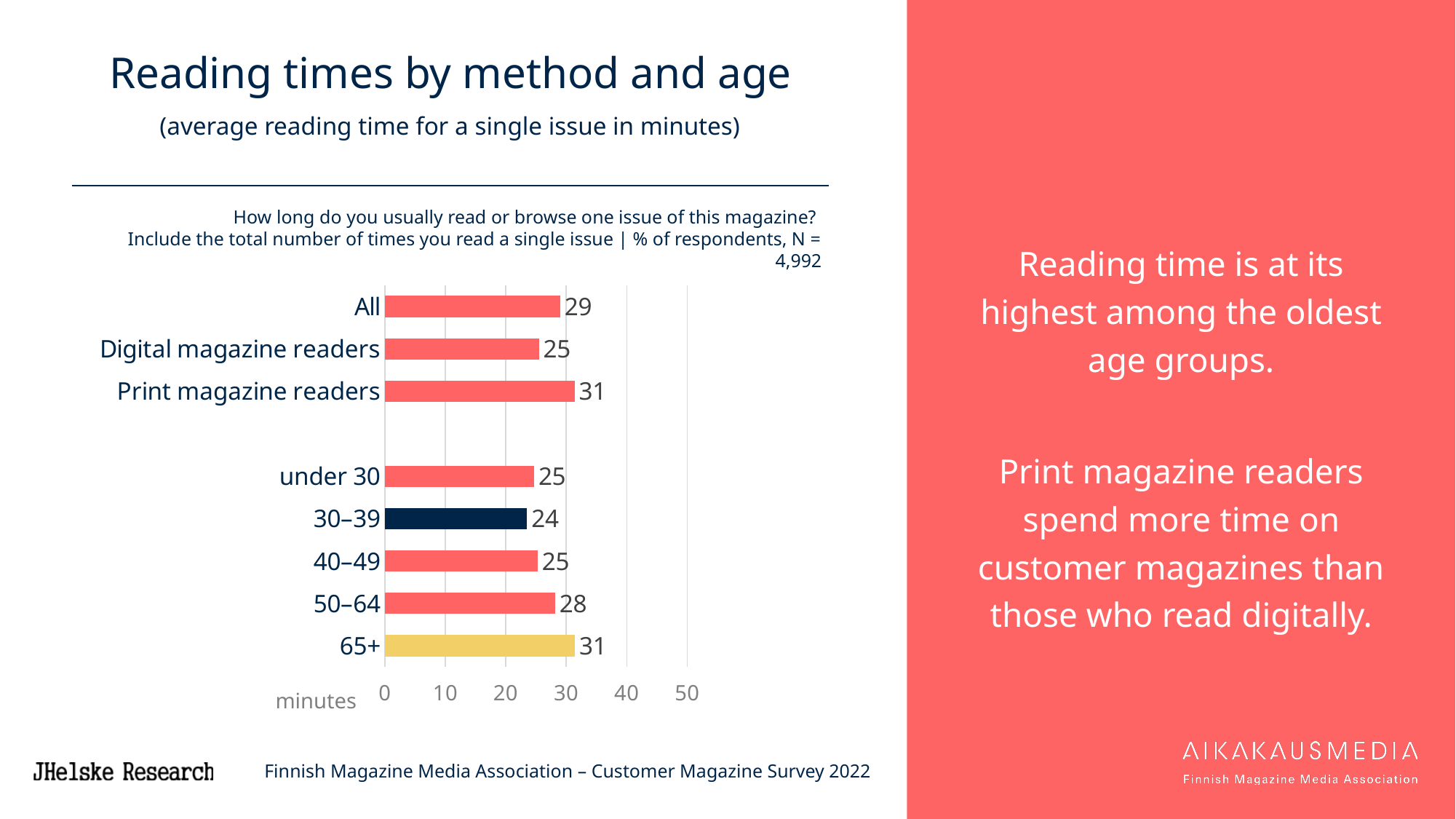
Which age group has the lowest average reading time? 30–39 What is the average reading time for Digital magazine readers? 25 Which bar in the chart is coloured yellow? 65+ What is the average reading time for the 30–39 age group? 24 What kind of chart is shown on the slide? Bar chart Which age group has the highest average reading time? 65+ Which has a higher average reading time, the 50–64 age group or the 40–49 age group? 50–64 What is the average reading time for Print magazine readers? 31 What is the difference in average reading time between Print magazine readers and Digital magazine readers? 6 How many bars are plotted in the chart? 8 What is the average reading time for the 65+ age group? 31 What is the average reading time for All respondents? 29